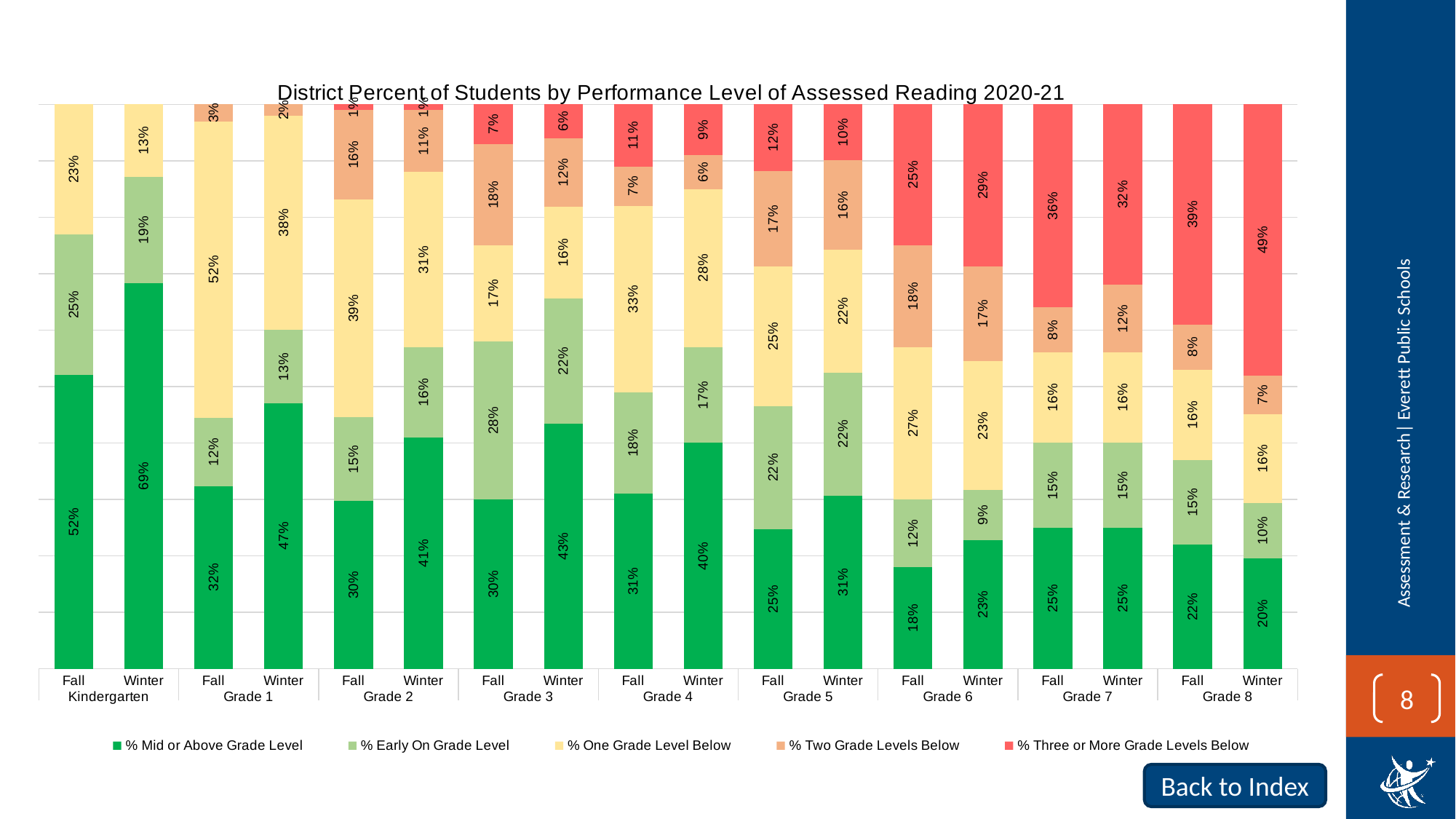
How many bars are plotted in the chart? 18 Which bar has the highest % Mid or Above Grade Level value? Kindergarten Winter Which bar has the lowest % Mid or Above Grade Level value? Grade 6 Fall What is the % One Grade Level Below value for Grade 1 Fall? 52% What type of chart is shown on the slide? Stacked bar chart What is the % Three or More Grade Levels Below value for Grade 8 Winter? 49% What is the % Mid or Above Grade Level value for Kindergarten Winter? 69% How many series does the legend list? 5 What is the % Two Grade Levels Below value for Grade 5 Fall? 17% Which is larger, the % Three or More Grade Levels Below value for Grade 7 Fall or for Grade 7 Winter? Grade 7 Fall What is the title of the chart? District Percent of Students by Performance Level of Assessed Reading 2020-21 What is the difference between the % Mid or Above Grade Level values for Grade 3 Winter and Grade 3 Fall? 13%